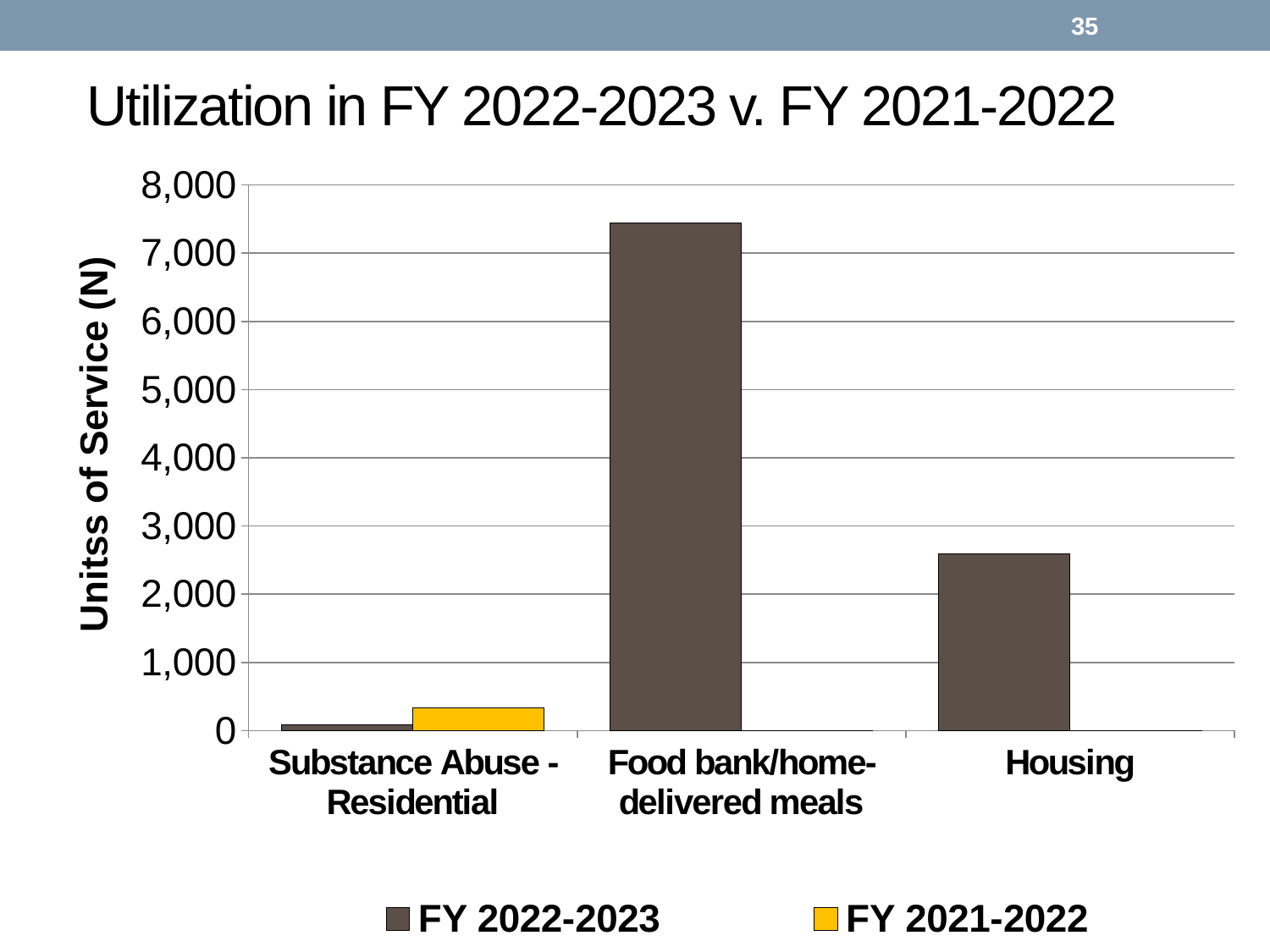
What is the title of the chart? Utilization in FY 2022-2023 v. FY 2021-2022 Is the FY 2022-2023 value for Food bank/home-delivered meals greater or less than 7,000? greater What is the label of the vertical axis? Unitss of Service (N) How many series does the legend list? 2 Which is larger: the FY 2022-2023 value for Housing or the FY 2022-2023 value for Food bank/home-delivered meals? Food bank/home-delivered meals What kind of chart is shown on the slide? bar chart For Substance Abuse - Residential, which is larger: the FY 2022-2023 value or the FY 2021-2022 value? FY 2021-2022 Is the FY 2021-2022 value for Substance Abuse - Residential greater or less than 1,000? less How many categories are shown on the x axis? 3 Which category has the highest FY 2022-2023 value? Food bank/home-delivered meals Is the FY 2022-2023 value for Housing greater or less than 3,000? less Which category has the lowest FY 2022-2023 value? Substance Abuse - Residential